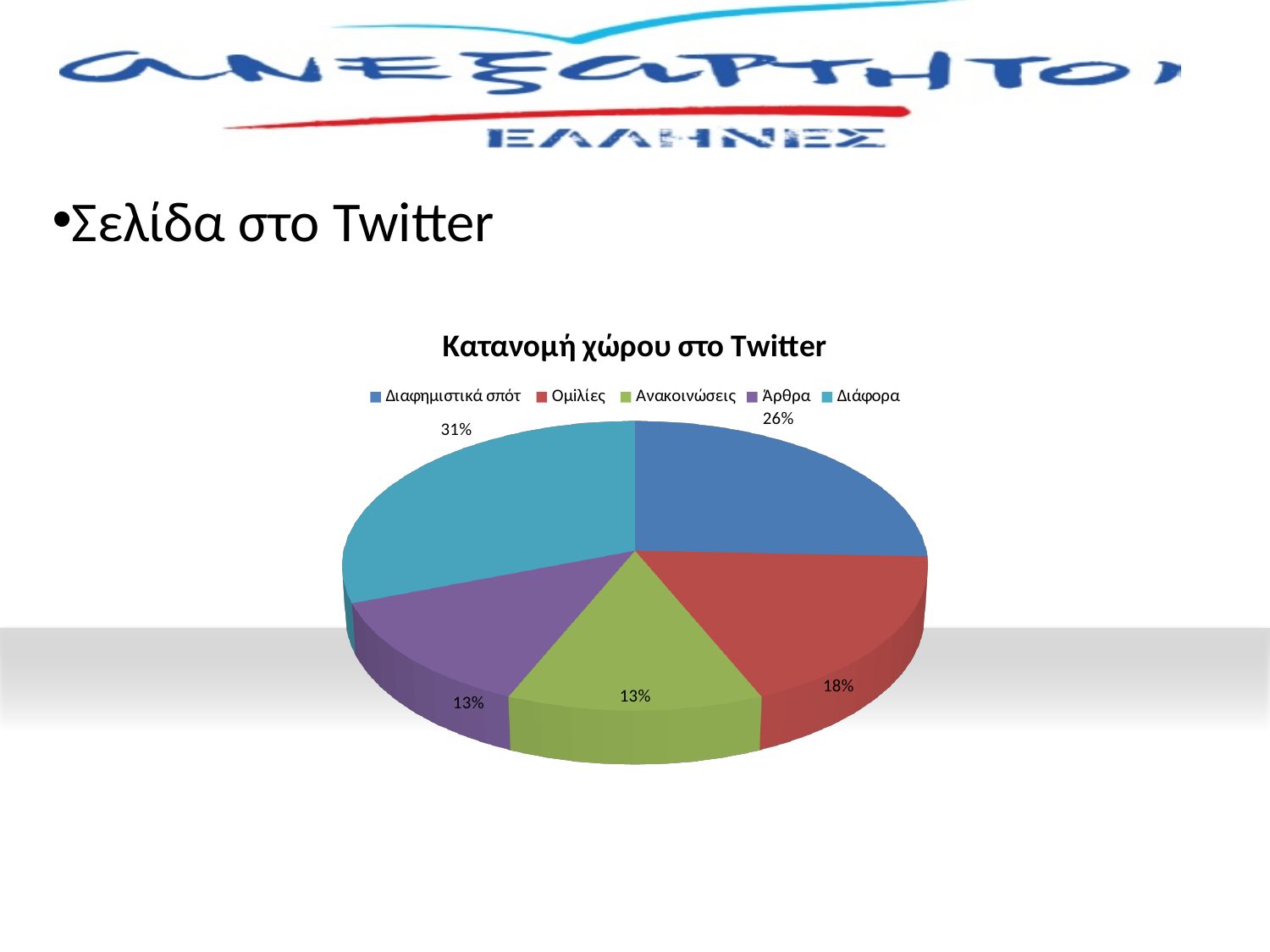
What percentage of the pie is Ανακοινώσεις? 13% What percentage of the pie is Διάφορα? 31% What percentage of the pie is Ομιλίες? 18% What is the difference in percentage points between Διάφορα and Διαφημιστικά σποτ? 5 How many categories does the legend list? 5 Which is larger, the share for Ομιλίες or the share for Άρθρα? Ομιλίες What percentage of the pie is Διαφημιστικά σποτ? 26% Which colour represents Διάφορα in the chart? Light blue (cyan) Which category has the largest share of the pie? Διάφορα What type of chart is shown on the slide? Pie chart What is the combined share of Ανακοινώσεις and Άρθρα? 26% What is the title of the chart? Κατανομή χώρου στο Twitter